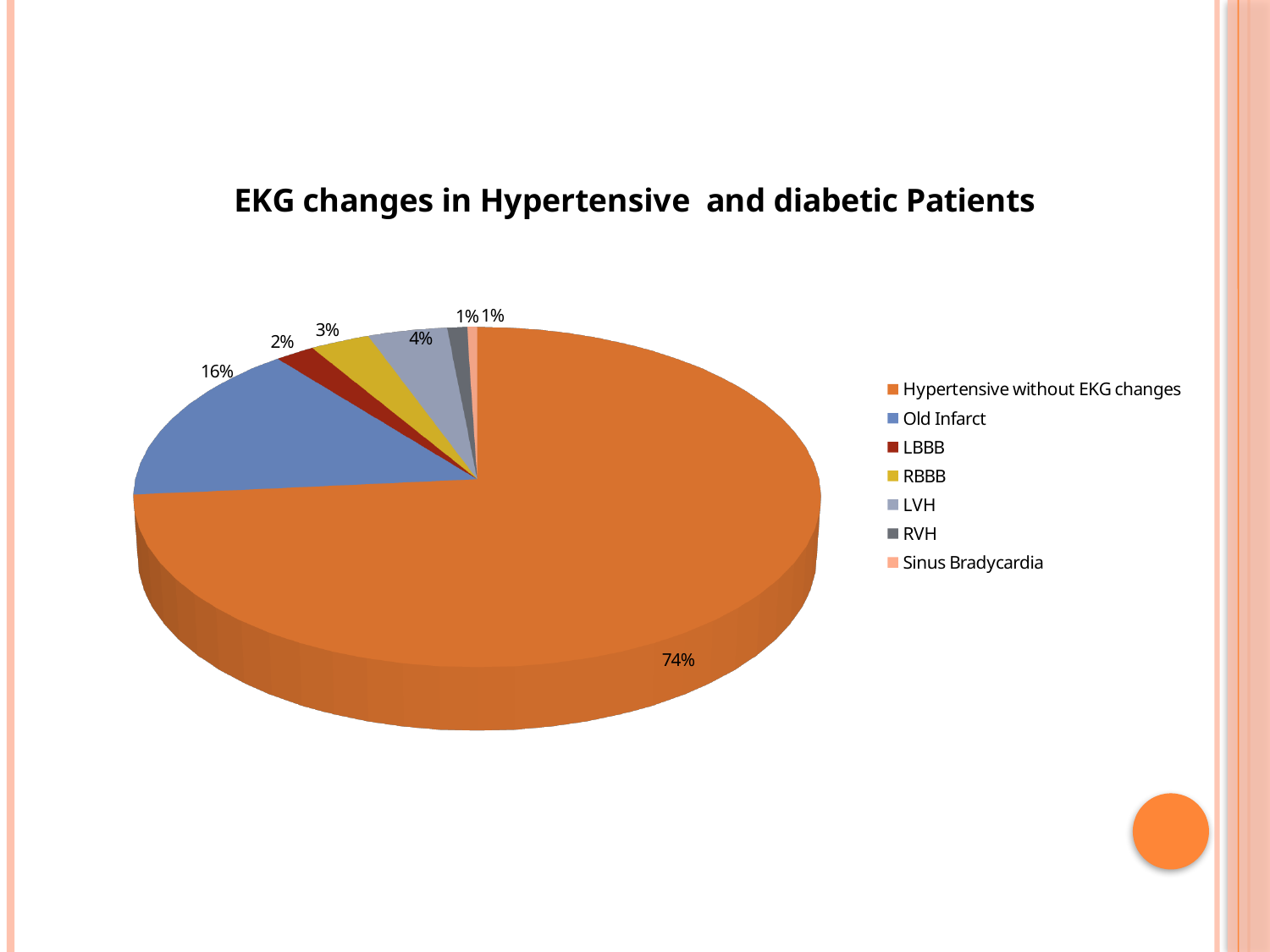
How many categories does the legend list? 7 What share of the pie is Old Infarct? 16% What share of the pie is RBBB? 3% Which category has the largest slice of the pie? Hypertensive without EKG changes What share of the pie is LBBB? 2% Which is larger, the RBBB slice or the LBBB slice? RBBB What colour is the Old Infarct slice? blue What kind of chart is shown on the slide? pie chart What is the difference between the Old Infarct share and the LVH share? 12% What is the title of the chart? EKG changes in Hypertensive and diabetic Patients